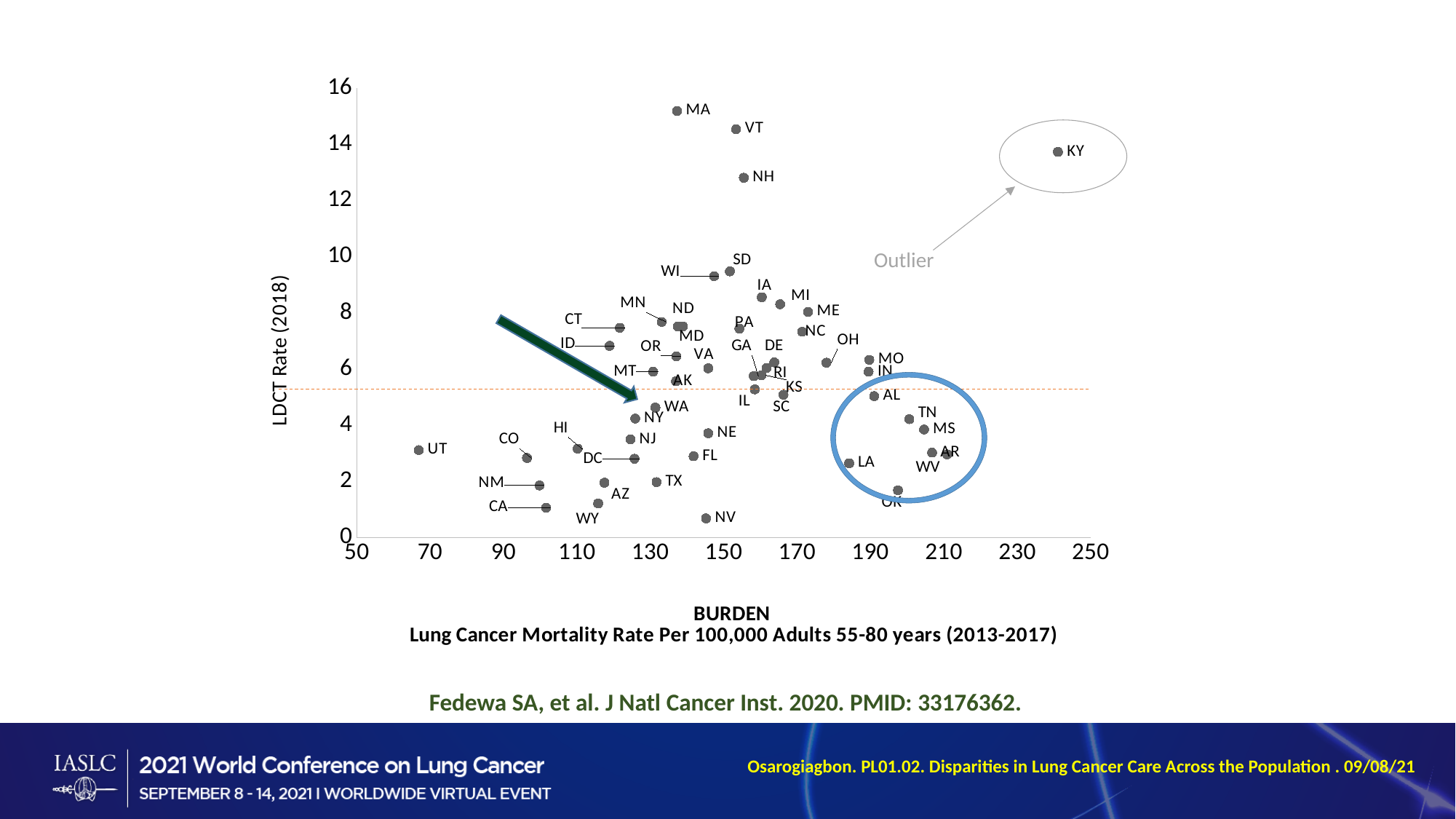
Is the LDCT Rate (2018) for KY greater or less than 12? greater Which state is labeled as the outlier on the chart? KY Which state has the lowest lung cancer mortality rate (burden) on the x axis? UT Which state has the higher LDCT Rate (2018), VT or NH? VT Is the burden (lung cancer mortality rate) for KY greater or less than 230? greater Is the LDCT Rate (2018) for LA greater or less than 4? less What is the label of the y axis of the chart? LDCT Rate (2018) Which state has the highest lung cancer mortality rate (burden) on the x axis? KY Which state has the highest LDCT Rate (2018) on the chart? MA What kind of chart is shown on the slide? Scatter plot Which state has the lowest LDCT Rate (2018) on the chart? NV